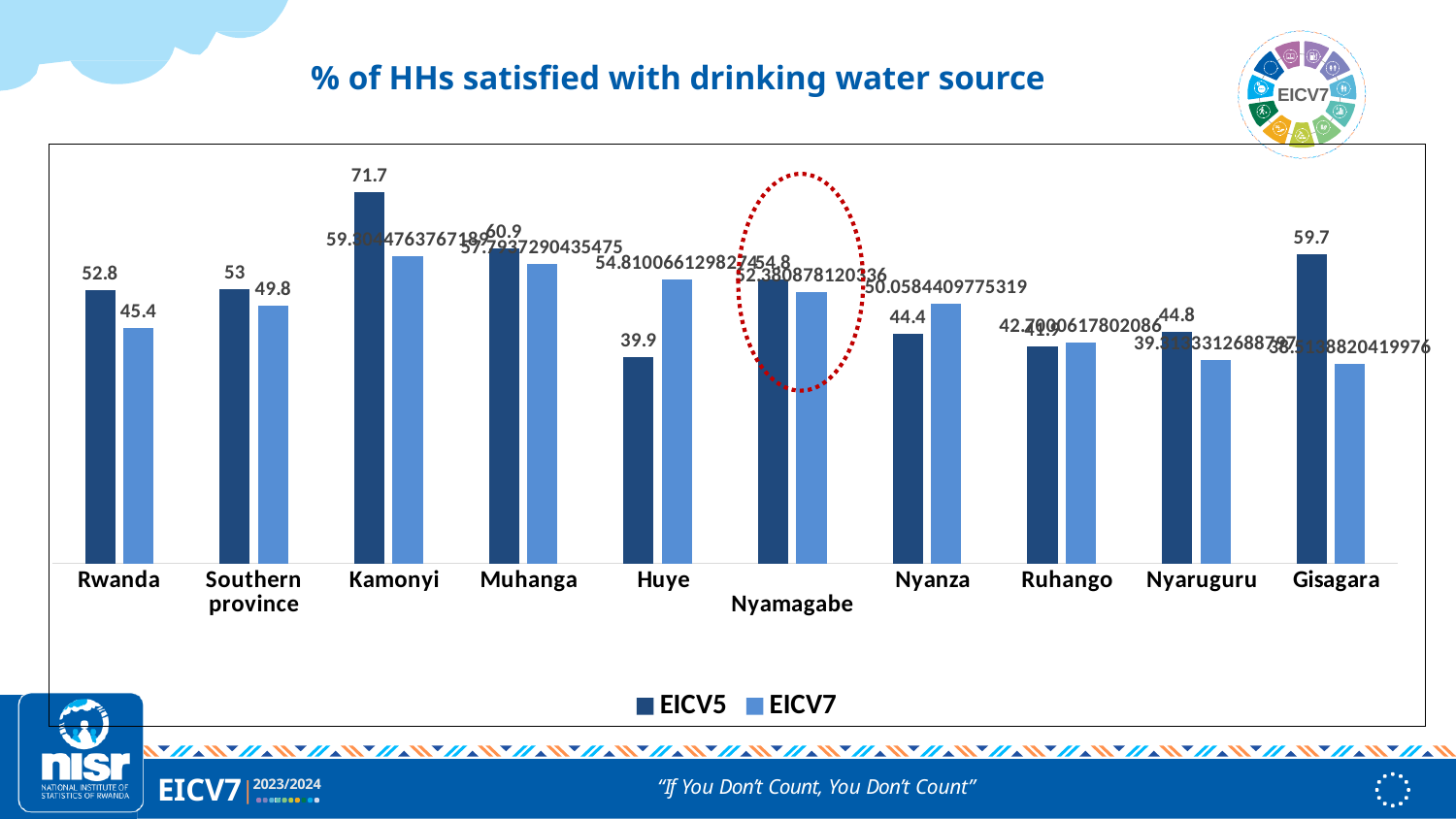
What is the EICV5 value for Rwanda? 52.8 Which category has the highest EICV5 value? Kamonyi What is the difference between the EICV5 and EICV7 values for Southern province? 3.2 What is the EICV5 value for Gisagara? 59.7 Which category has the lowest EICV5 value? Huye How many categories are shown on the x axis? 10 For Gisagara, which is larger: the EICV5 value or the EICV7 value? EICV5 What is the EICV7 value for Rwanda? 45.4 For Huye, which is larger: the EICV5 value or the EICV7 value? EICV7 What is the difference between the EICV5 and EICV7 values for Rwanda? 7.4 How many series does the legend list? 2 What is the EICV5 value for Kamonyi? 71.7